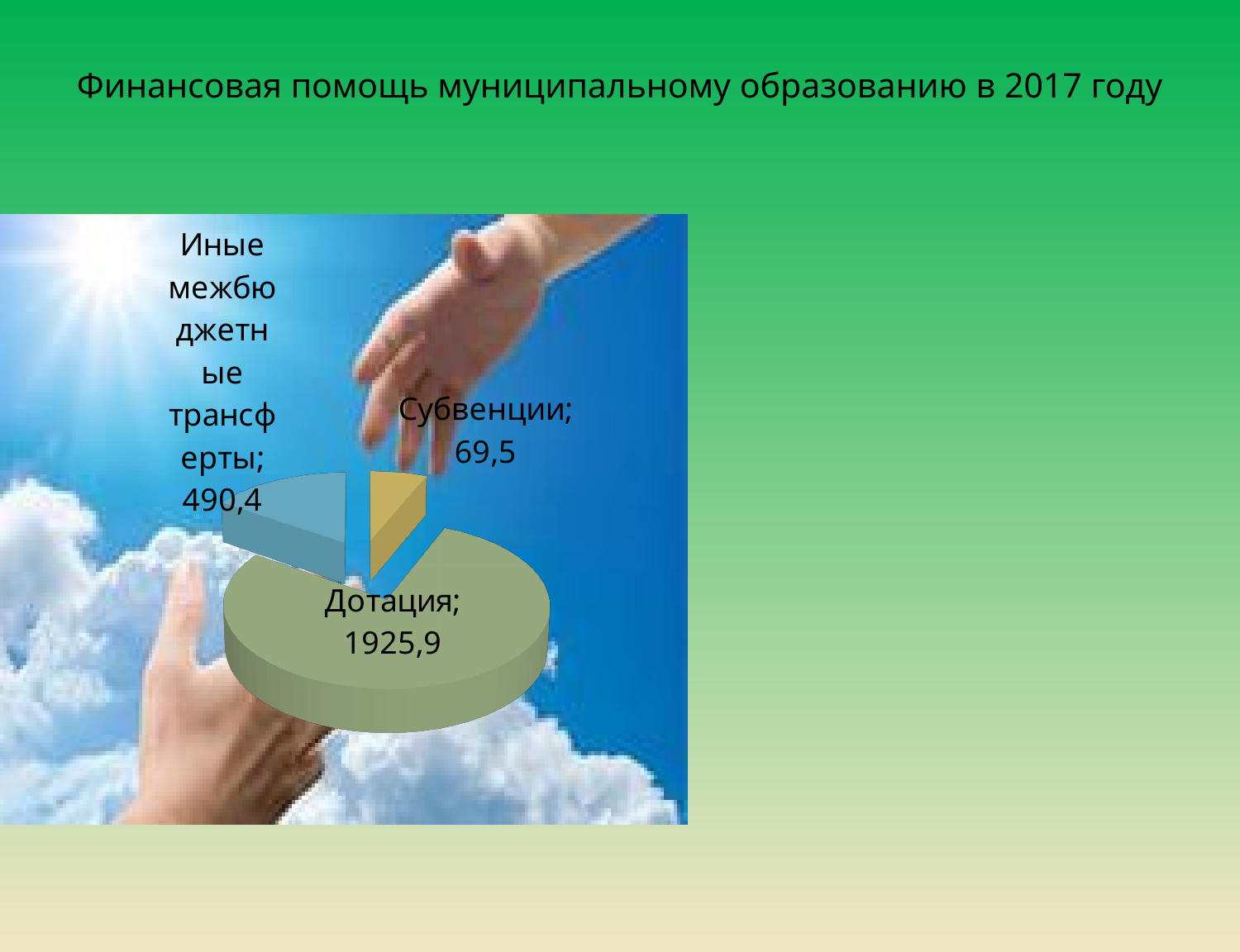
What is the value for Субвенции? 69,5 What is the value for Дотация? 1925,9 What is the value for Иные межбюджетные трансферты? 490,4 What is the difference between the values for Иные межбюджетные трансферты and Субвенции? 420,9 Which category has the largest slice of the pie? Дотация What is the title of the slide containing the chart? Финансовая помощь муниципальному образованию в 2017 году What is the difference between the values for Дотация and Иные межбюджетные трансферты? 1435,5 What is the total of all three slices in the pie chart? 2485,8 Which category has the smallest slice of the pie? Субвенции What type of chart is shown on the slide? Pie chart How many slices does the pie chart have? 3 Which is larger, the value for Иные межбюджетные трансферты or the value for Субвенции? Иные межбюджетные трансферты